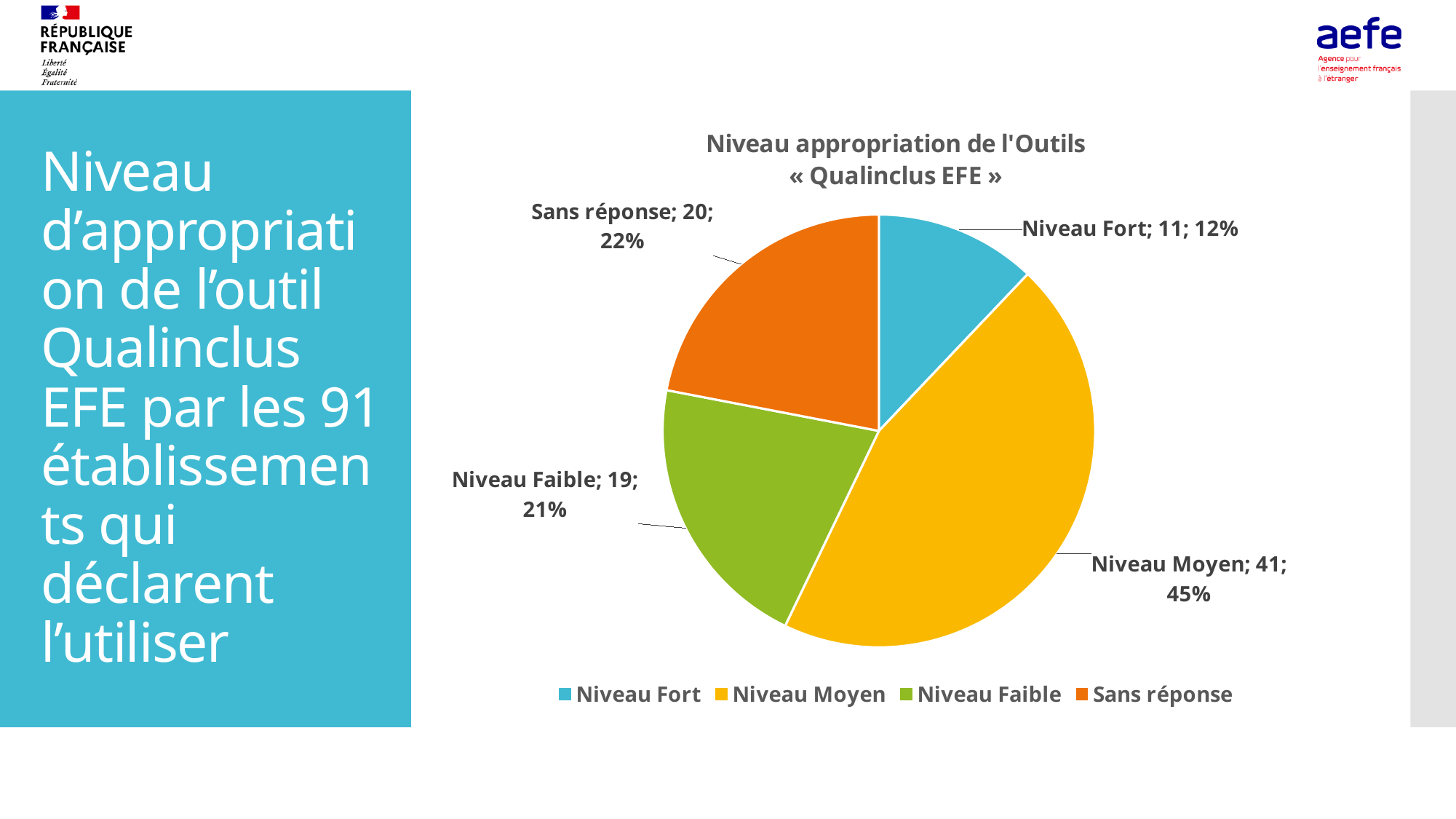
What percentage share does Niveau Fort have? 12% Which is larger, the count for Sans réponse or the count for Niveau Fort? Sans réponse What is the title of the chart? Niveau appropriation de l'Outils « Qualinclus EFE » What kind of chart is shown on the slide? pie chart Which category has the largest slice? Niveau Moyen What is the count for Niveau Moyen? 41 What percentage share does Niveau Faible have? 21% What is the count for Sans réponse? 20 How many slices does the pie chart have? 4 Which category has the smallest slice? Niveau Fort How many entries does the legend list? 4 What is the difference in count between Niveau Moyen and Niveau Faible? 22